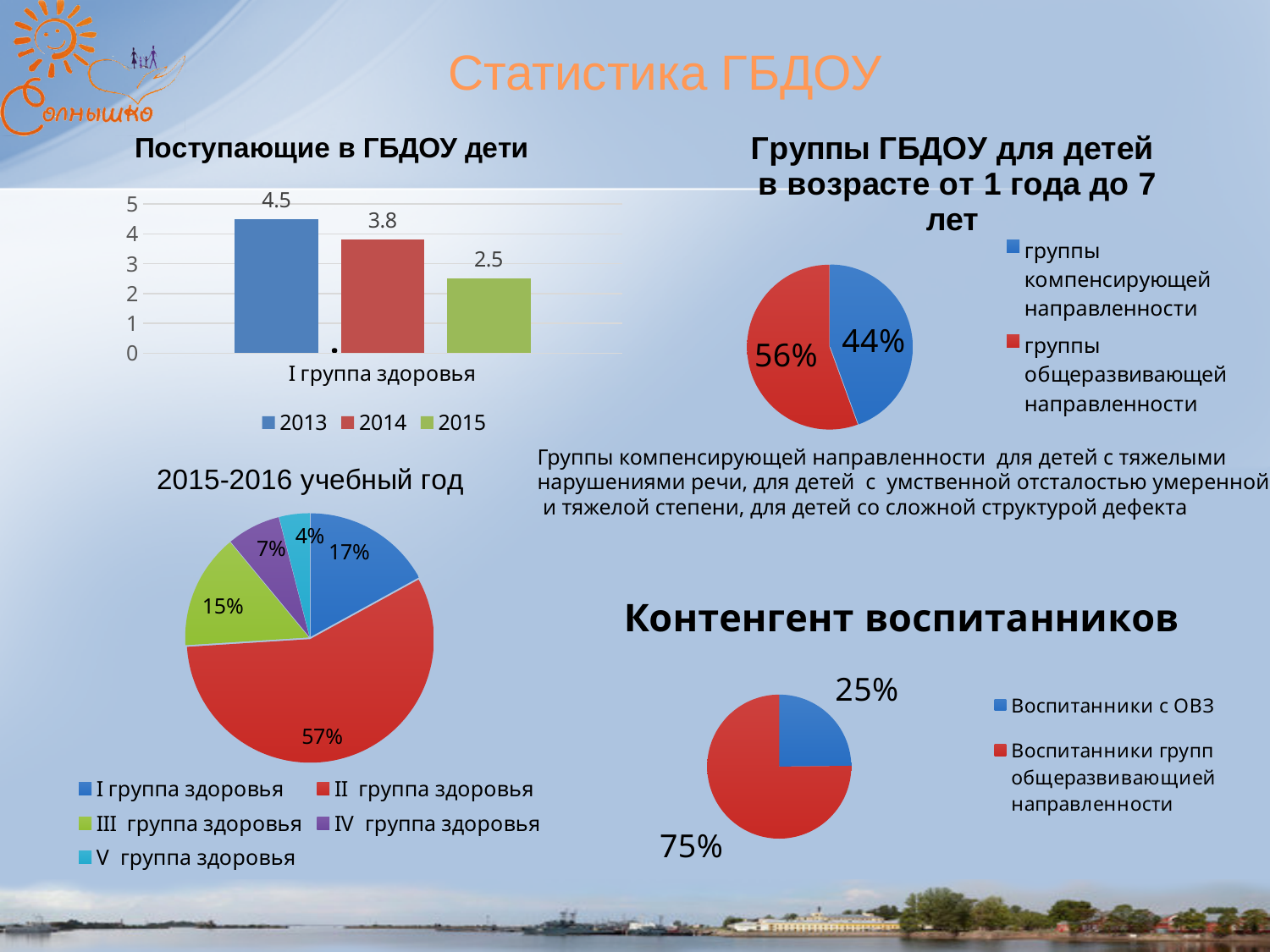
In the pie chart 'Контенгент воспитанников', what is the share of 'Воспитанники с ОВЗ'? 25% In the bar chart 'Поступающие в ГБДОУ дети', what is the difference between the 2013 and 2014 values? 0.7 How many slices does the pie chart '2015-2016 учебный год' have? 5 In the bar chart 'Поступающие в ГБДОУ дети', which year has the lowest value? 2015 In the pie chart '2015-2016 учебный год', what is the share of 'II группа здоровья'? 57% How many series does the legend of the bar chart 'Поступающие в ГБДОУ дети' list? 3 In the bar chart 'Поступающие в ГБДОУ дети', do the values rise or fall from 2013 to 2015? fall In the pie chart '2015-2016 учебный год', which health group has the smallest share? V группа здоровья In the pie chart 'Группы ГБДОУ для детей в возрасте от 1 года до 7 лет', what share do the 'группы компенсирующей направленности' have? 44% In the bar chart 'Поступающие в ГБДОУ дети', what is the value for 2013? 4.5 What kind of chart is 'Поступающие в ГБДОУ дети'? bar chart In the bar chart 'Поступающие в ГБДОУ дети', what is the value for 2015? 2.5